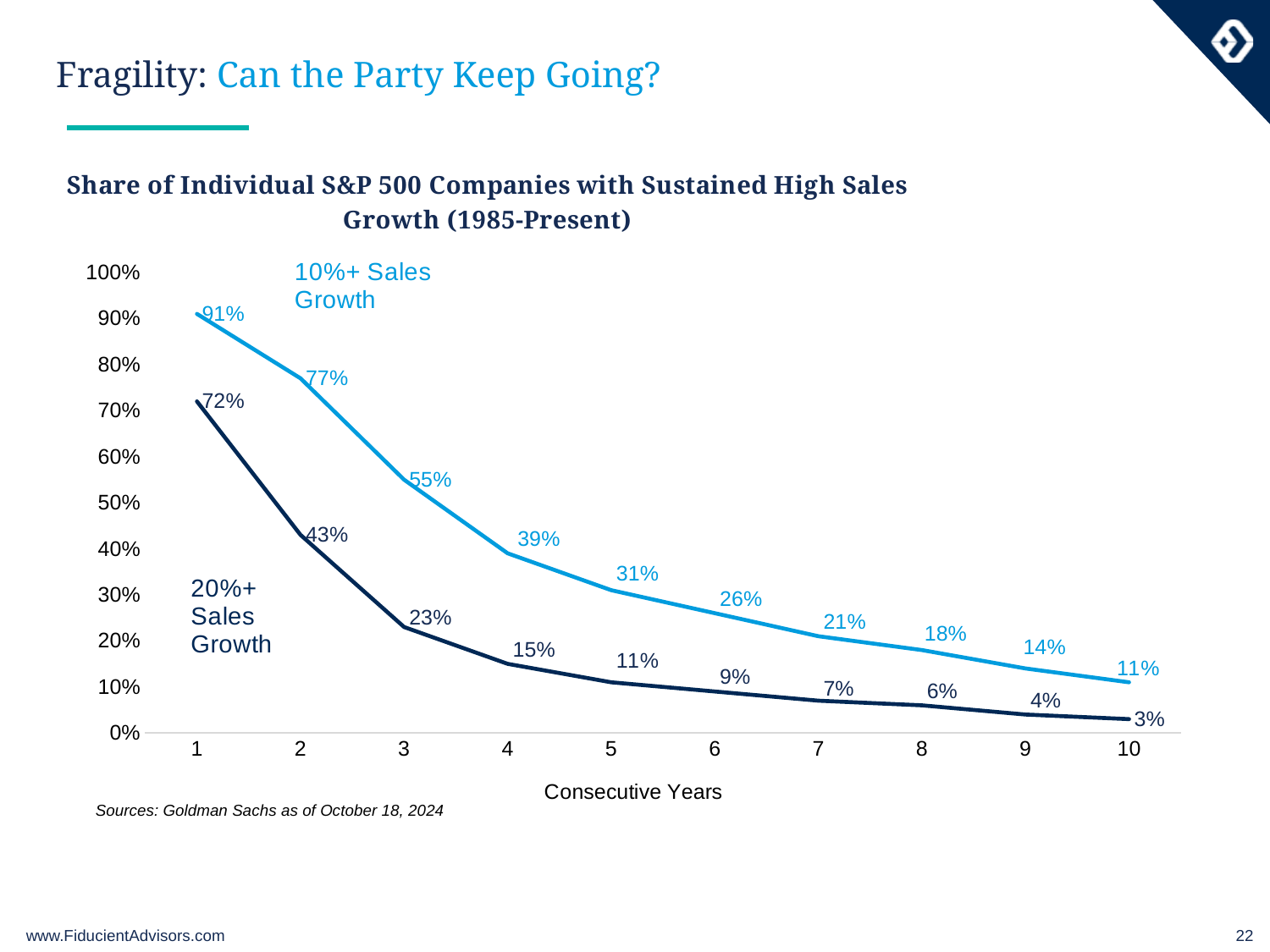
What is the difference between the 10%+ Sales Growth and 20%+ Sales Growth values at 2 consecutive years? 34% What is the value for the 10%+ Sales Growth series at 3 consecutive years? 55% What is the value for the 10%+ Sales Growth series at 10 consecutive years? 11% What is the label of the x axis? Consecutive Years Do the values of the 20%+ Sales Growth series rise or fall as the number of consecutive years increases? Fall At which number of consecutive years is the 10%+ Sales Growth series lowest? 10 What is the value for the 20%+ Sales Growth series at 5 consecutive years? 11% Which series has the larger value at 4 consecutive years, 10%+ Sales Growth or 20%+ Sales Growth? 10%+ Sales Growth How many points along the x axis (consecutive years) are plotted for each series? 10 How many series are plotted on the chart? 2 At which number of consecutive years is the 20%+ Sales Growth series highest? 1 What kind of chart is shown on the slide? Line chart